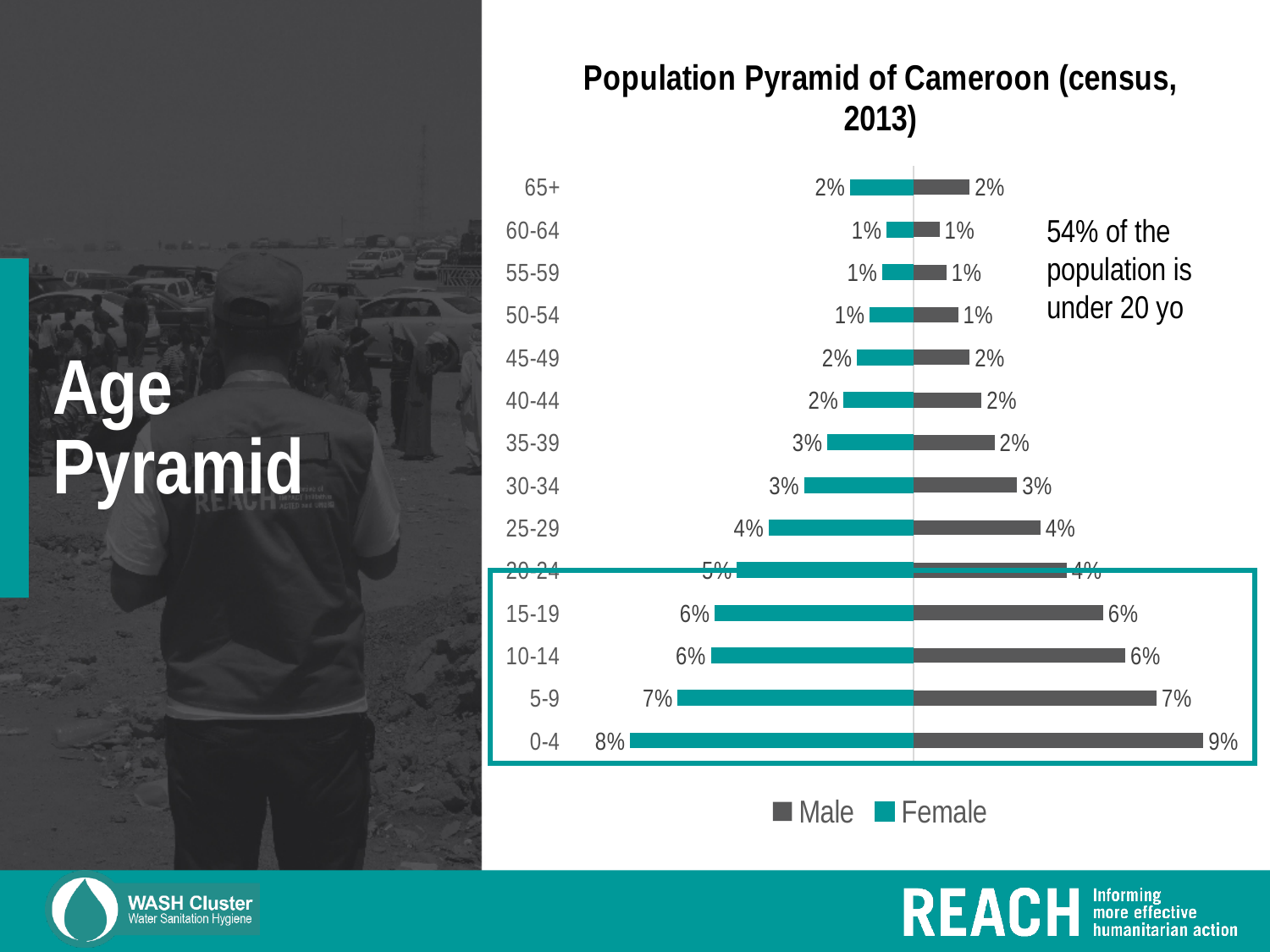
For the 35-39 age group, which is larger, the Male or the Female value? Female How many age groups are shown on the chart? 14 Which age group has the highest Male value? 0-4 Which age group has the highest Female value? 0-4 What is the difference between the Male and Female values for the 0-4 age group? 1% Going from the 0-4 age group up to the 50-54 age group, do the Male values rise or fall? Fall What is the Male value for the 0-4 age group? 9% How many series does the legend list? 2 What is the Female value for the 35-39 age group? 3% What is the Male value for the 25-29 age group? 4% What is the Female value for the 0-4 age group? 8% What kind of chart is shown on the slide? Bar chart